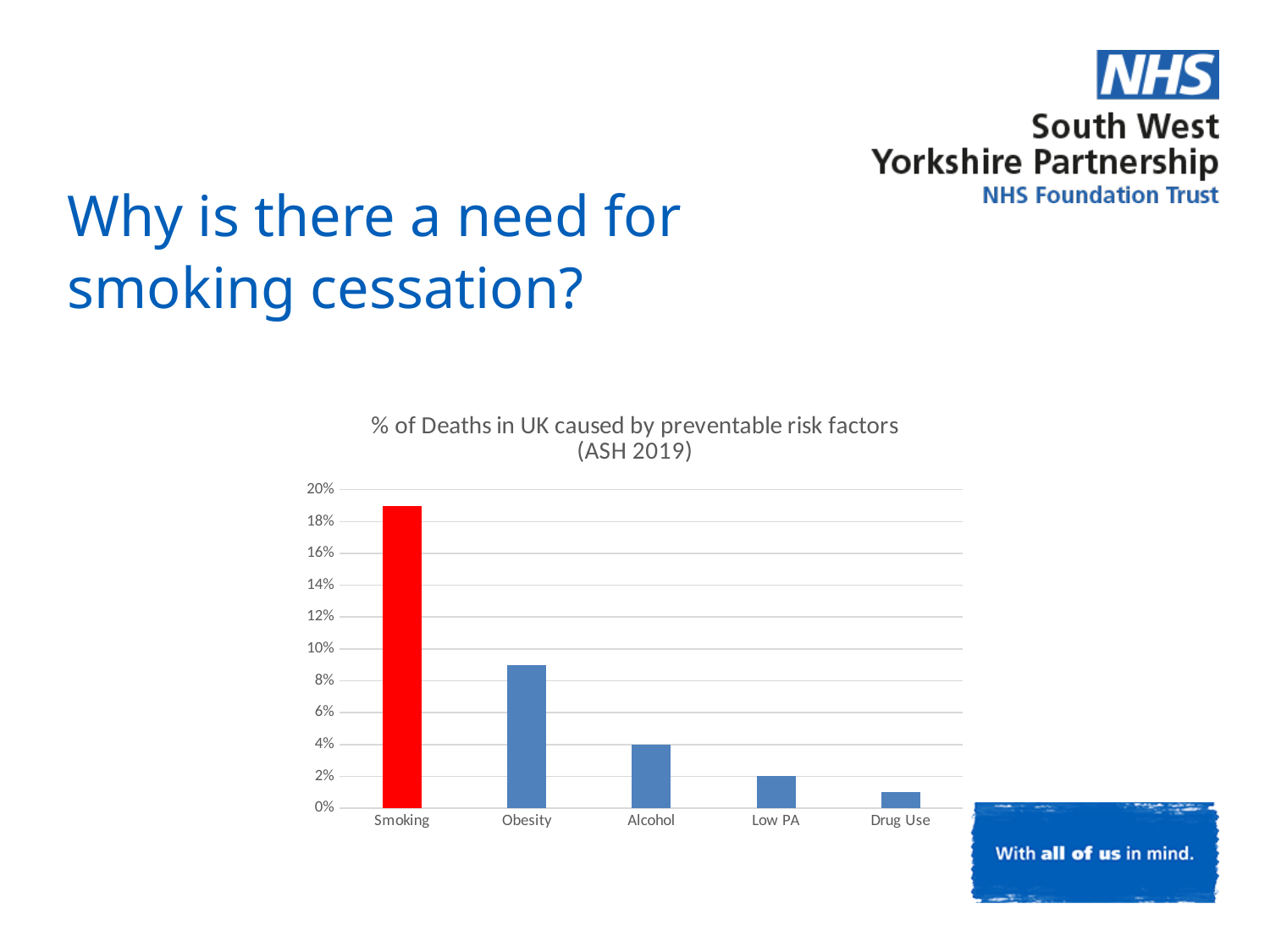
Which bar is coloured red on the chart? Smoking What kind of chart is shown on the slide? bar chart Is the value for Obesity greater or less than 10%? less Which risk factor has the lowest percentage of deaths? Drug Use What is the value for Low PA? 2% Which risk factor has the highest percentage of deaths? Smoking How many risk factor categories are shown on the chart? 5 Is the value for Drug Use greater or less than 2%? less Do the values rise or fall from left to right across the categories? fall Which is larger, the value for Obesity or the value for Alcohol? Obesity What is the value for Alcohol? 4% Is the value for Smoking greater or less than 18%? greater